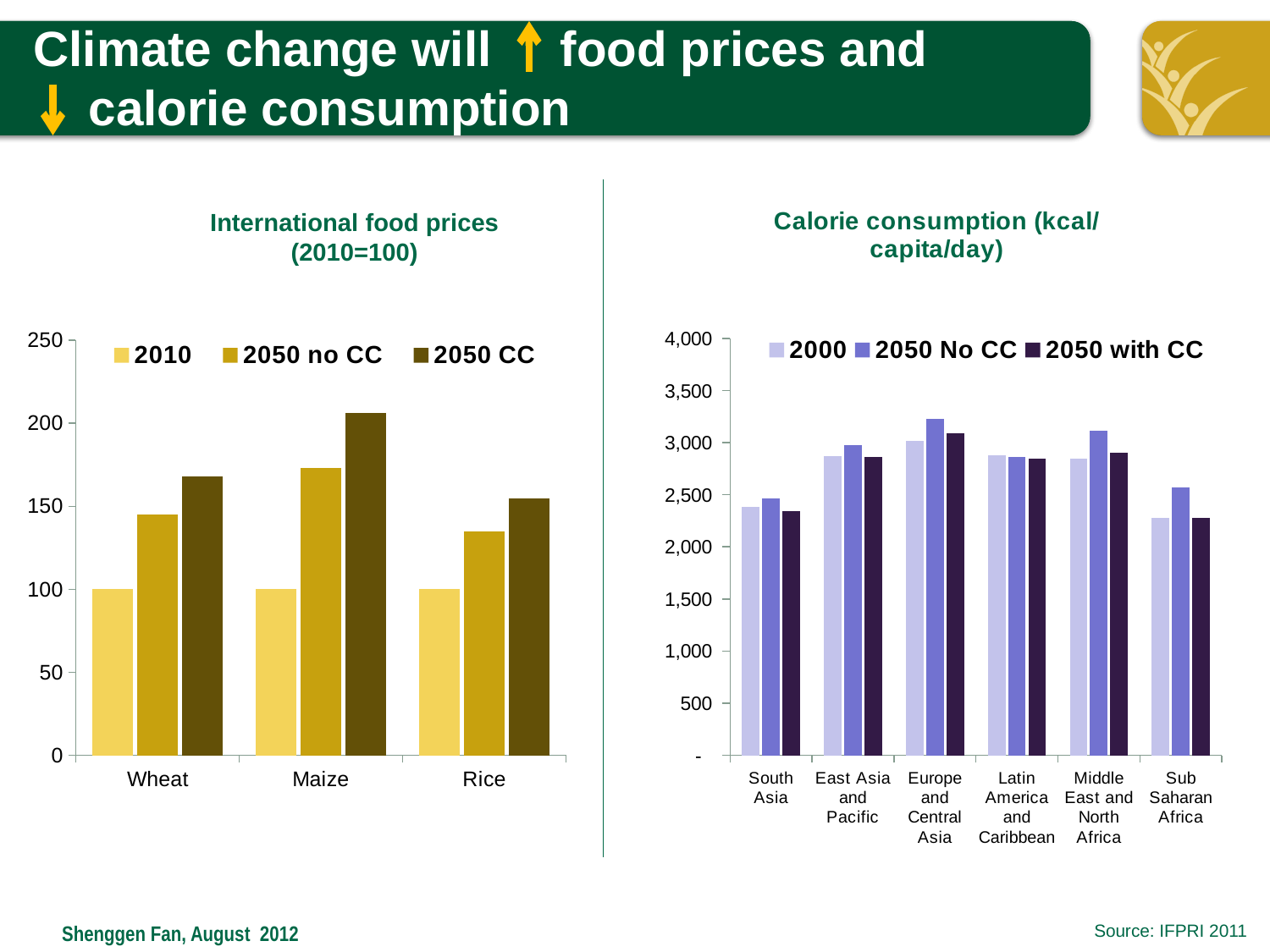
How many regions are shown on the x axis of the 'Calorie consumption (kcal/capita/day)' chart? 6 In the 'International food prices (2010=100)' chart, what is the 2010 value for Wheat? 100 How many series does the legend of the 'Calorie consumption (kcal/capita/day)' chart list? 3 In the 'International food prices (2010=100)' chart, is the 2050 no CC value for Rice greater or less than 150? less In the 'International food prices (2010=100)' chart, is the 2050 CC value for Wheat greater or less than 150? greater In the 'International food prices (2010=100)' chart, which crop has the highest 2050 CC value? Maize What kind of chart is the 'International food prices (2010=100)' chart? bar chart How many series does the legend of the 'International food prices (2010=100)' chart list? 3 In the 'Calorie consumption (kcal/capita/day)' chart, which is larger for Middle East and North Africa: the 2050 No CC value or the 2050 with CC value? 2050 No CC How many crop categories are shown on the x axis of the 'International food prices (2010=100)' chart? 3 In the 'Calorie consumption (kcal/capita/day)' chart, is the 2050 No CC value for Europe and Central Asia greater or less than 3,000? greater In the 'International food prices (2010=100)' chart, which is larger: the 2050 no CC value for Maize or the 2050 no CC value for Wheat? Maize